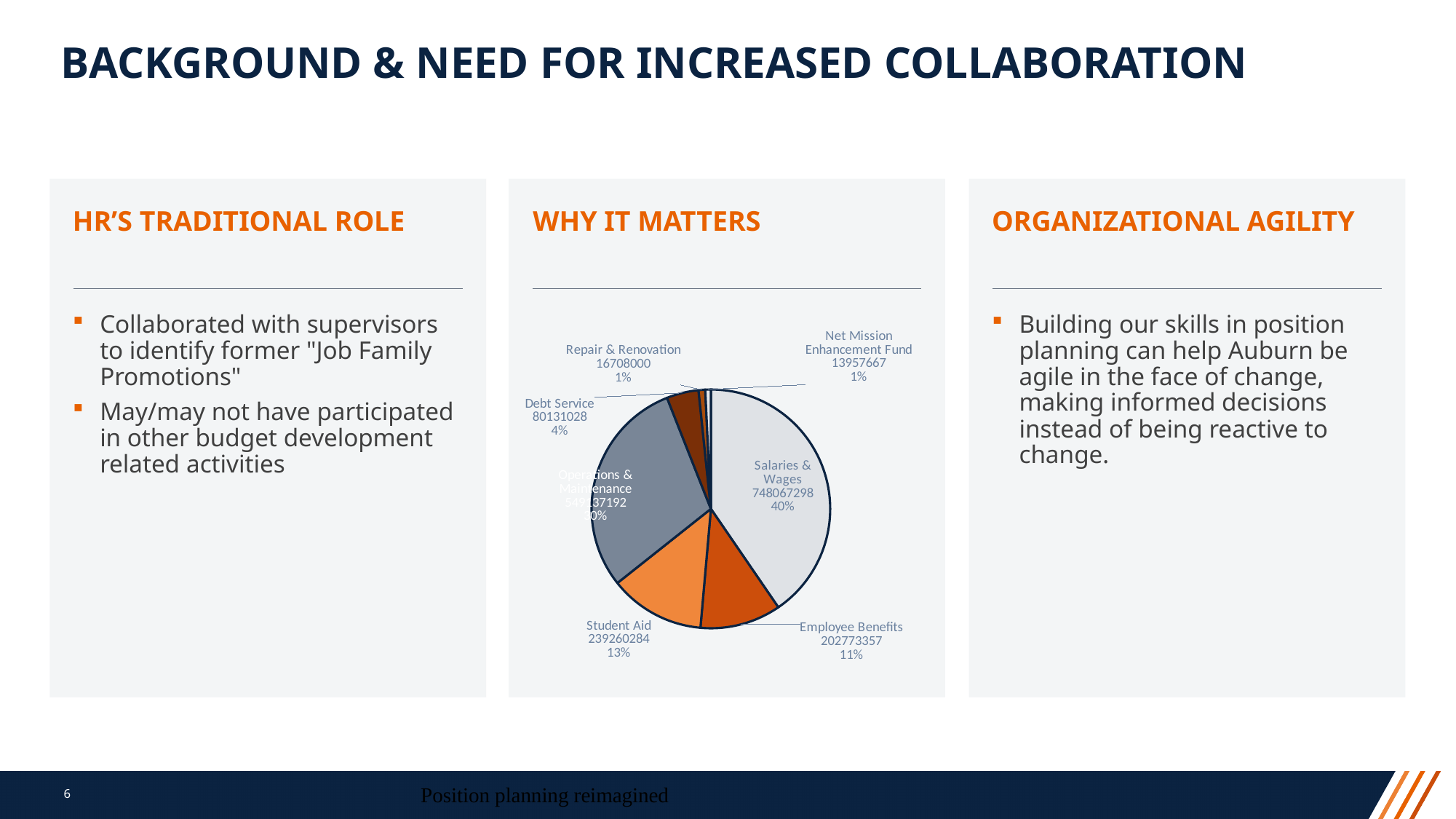
What kind of chart is shown in the "Why It Matters" panel? pie chart What percentage is shown for Student Aid? 13% Which is larger, Student Aid or Employee Benefits? Student Aid Which category has the smallest value in the pie chart? Net Mission Enhancement Fund How many slices does the pie chart have? 7 What is the value shown for Salaries & Wages? 748067298 What is the value shown for Debt Service? 80131028 What is the difference between the Student Aid value and the Employee Benefits value? 36486927 What percentage is shown for Net Mission Enhancement Fund? 1% What is the value shown for Employee Benefits? 202773357 Which category has the largest slice of the pie chart? Salaries & Wages What share of the pie does Salaries & Wages represent? 40%